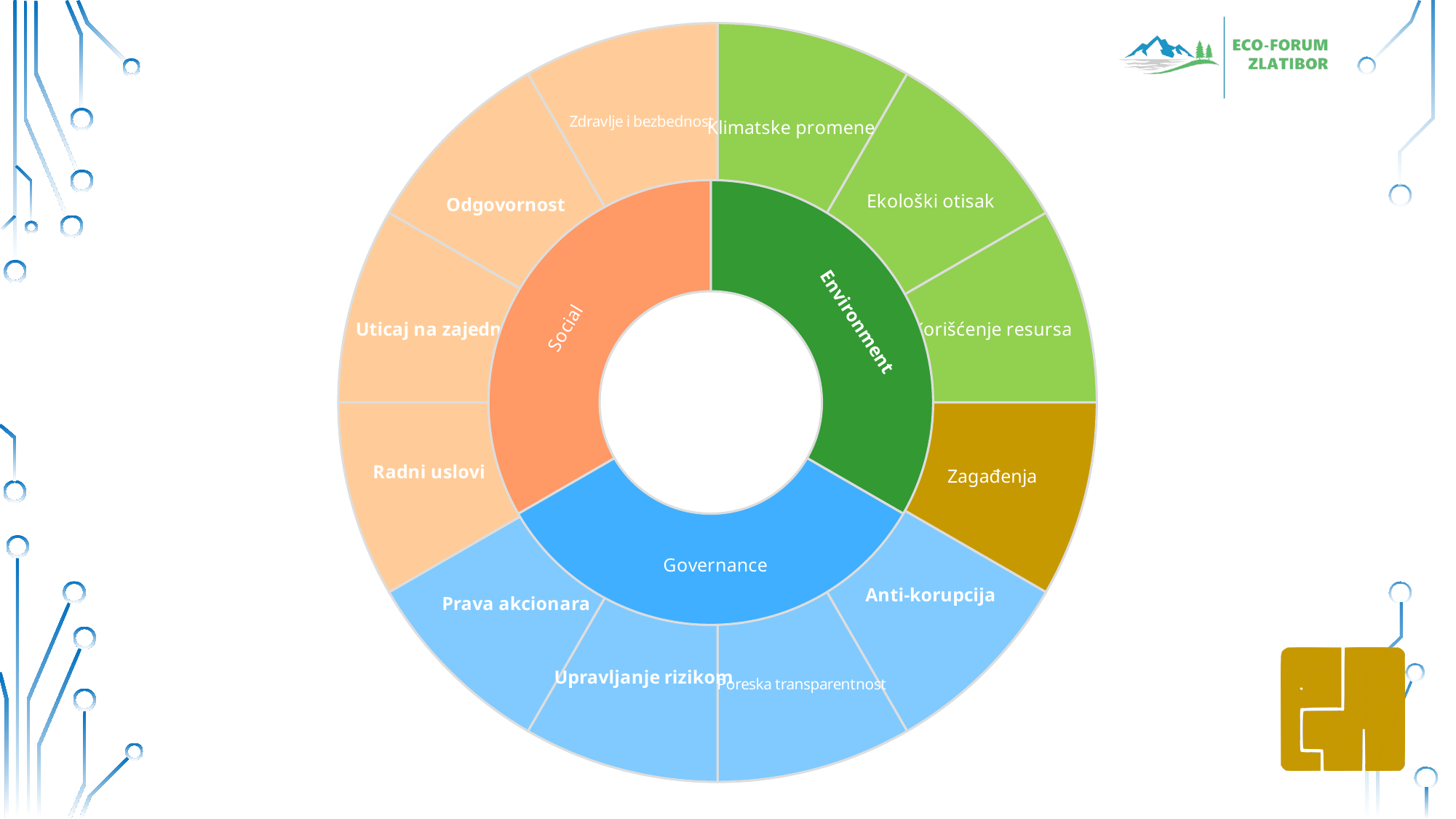
How many categories are in the inner ring of the chart? 3 How many outer-ring segments belong to the Environment category? 4 Which inner-ring category does the segment labelled 'Zagađenja' belong to? Environment What are the three labels shown in the inner ring of the chart? Social, Environment, Governance How many segments are in the outer ring of the chart? 12 What kind of chart is shown on the slide? doughnut chart Which inner-ring category does the segment labelled 'Anti-korupcija' belong to? Governance Which outer-ring segment of the Environment category is coloured dark gold rather than light green? Zagađenja